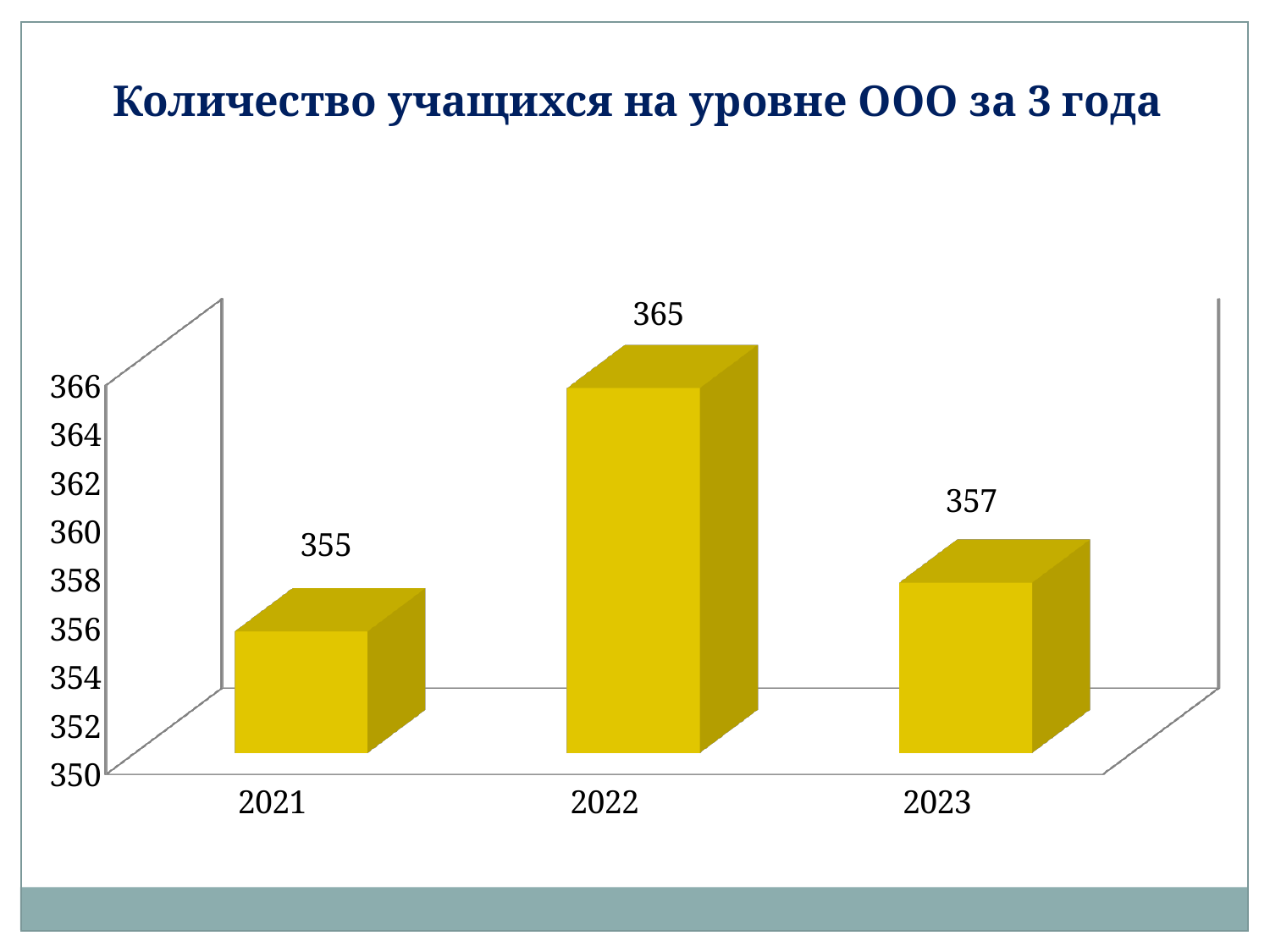
Which year has the highest number of students? 2022 What kind of chart is shown on the slide? bar chart What is the title of the chart? Количество учащихся на уровне ООО за 3 года What is the difference between the values for 2022 and 2023? 8 What is the number of students for 2023? 357 What is the difference between the values for 2022 and 2021? 10 What is the number of students for 2022? 365 Which year has the lowest number of students? 2021 What is the number of students for 2021? 355 Which is larger, the value for 2023 or the value for 2021? 2023 How many years are shown on the chart? 3 Is the value for 2022 greater or less than 360? greater